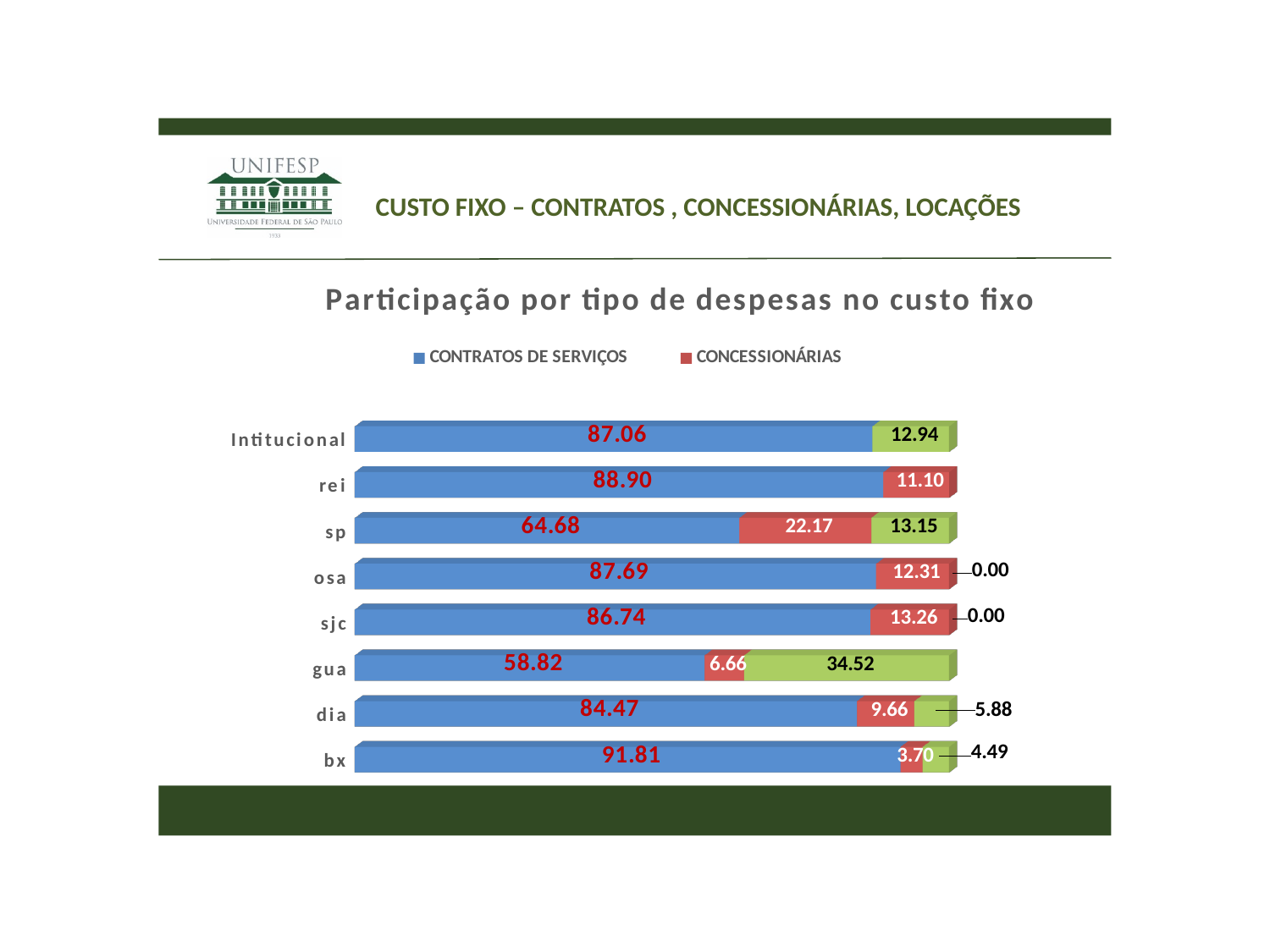
How many series does the legend list? 2 Which category has the highest value for CONCESSIONÁRIAS? sp What is the value for CONCESSIONÁRIAS for the category dia? 9.66 What is the value for CONTRATOS DE SERVIÇOS for the category gua? 58.82 What is the value for CONTRATOS DE SERVIÇOS for the category bx? 91.81 What is the difference between the CONTRATOS DE SERVIÇOS values for sp and gua? 5.86 Which is larger, the CONTRATOS DE SERVIÇOS value for rei or for osa? rei How many categories are shown on the chart? 8 Which category has the lowest value for CONTRATOS DE SERVIÇOS? gua Which category has the highest value for CONTRATOS DE SERVIÇOS? bx What type of chart is shown on the slide? Stacked bar chart What is the value for CONCESSIONÁRIAS for the category sp? 22.17